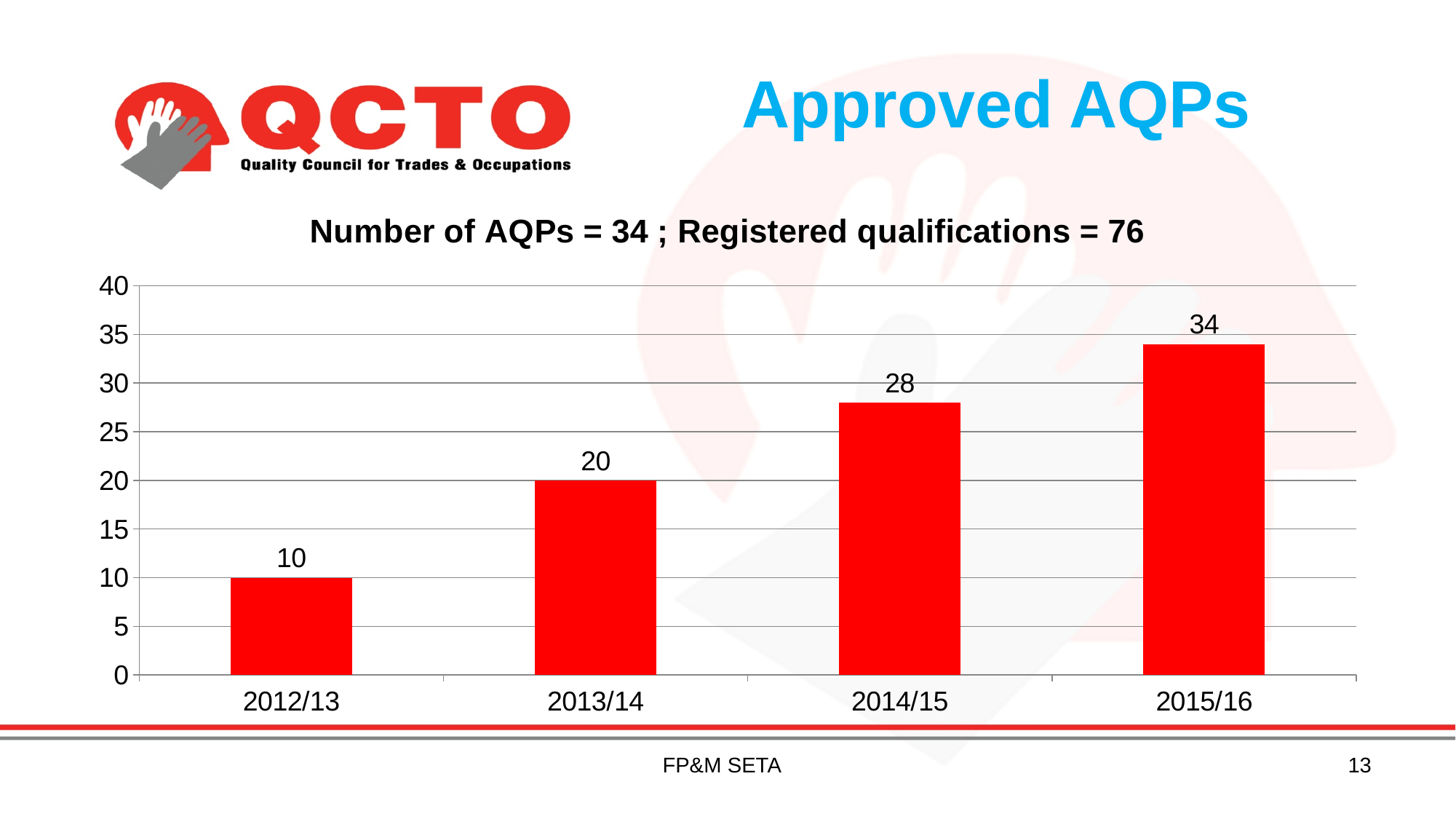
What is the difference between the values for 2015/16 and 2014/15? 6 What is the value for 2013/14? 20 Do the values rise or fall from 2012/13 to 2015/16? rise Which year has the lowest value? 2012/13 What is the value for 2012/13? 10 Is the value for 2014/15 greater or less than 25? greater What kind of chart is shown on the slide? bar chart How many years are shown on the x axis? 4 What is the value for 2014/15? 28 Which is larger, the value for 2013/14 or the value for 2014/15? 2014/15 Which year has the highest value? 2015/16 What is the value for 2015/16? 34